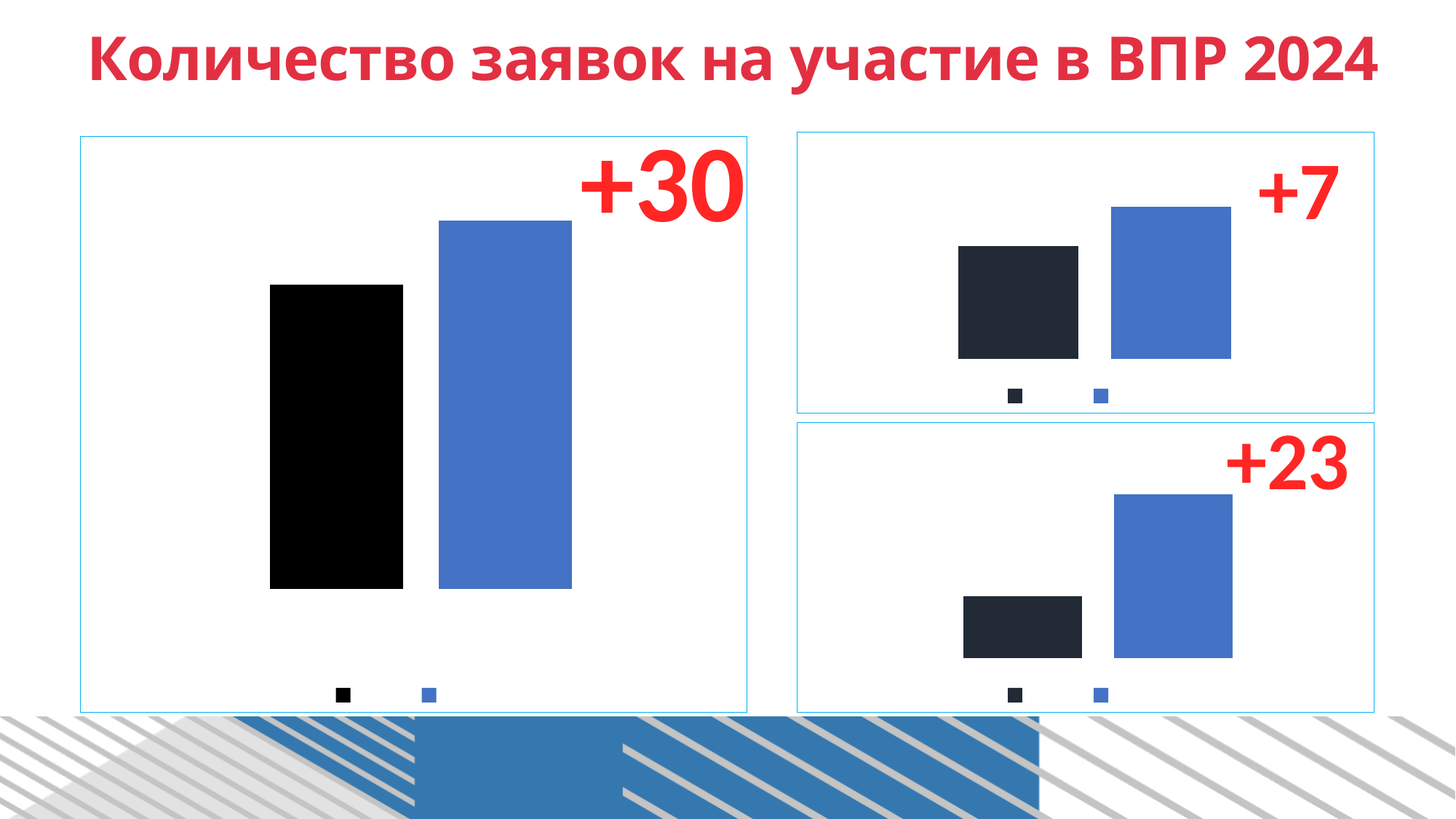
How many series does the legend of the large chart on the left list? 2 What kind of chart is the chart in the top-right of the slide? bar chart What red annotation is printed on the bottom-right chart? +23 How many series does the legend of the bottom-right chart list? 2 In the bottom-right chart, which bar is taller, the dark bar or the blue bar? the blue bar How many bars are plotted in the large chart on the left of the slide? 2 In the top-right chart, which bar is taller, the dark bar or the blue bar? the blue bar In the large chart on the left, which bar is taller, the black bar or the blue bar? the blue bar How many bars are plotted in the top-right chart? 2 What red annotation is printed in the top-right corner of the large chart on the left? +30 What kind of chart is the large chart on the left of the slide? bar chart How many charts are shown on the slide? 3